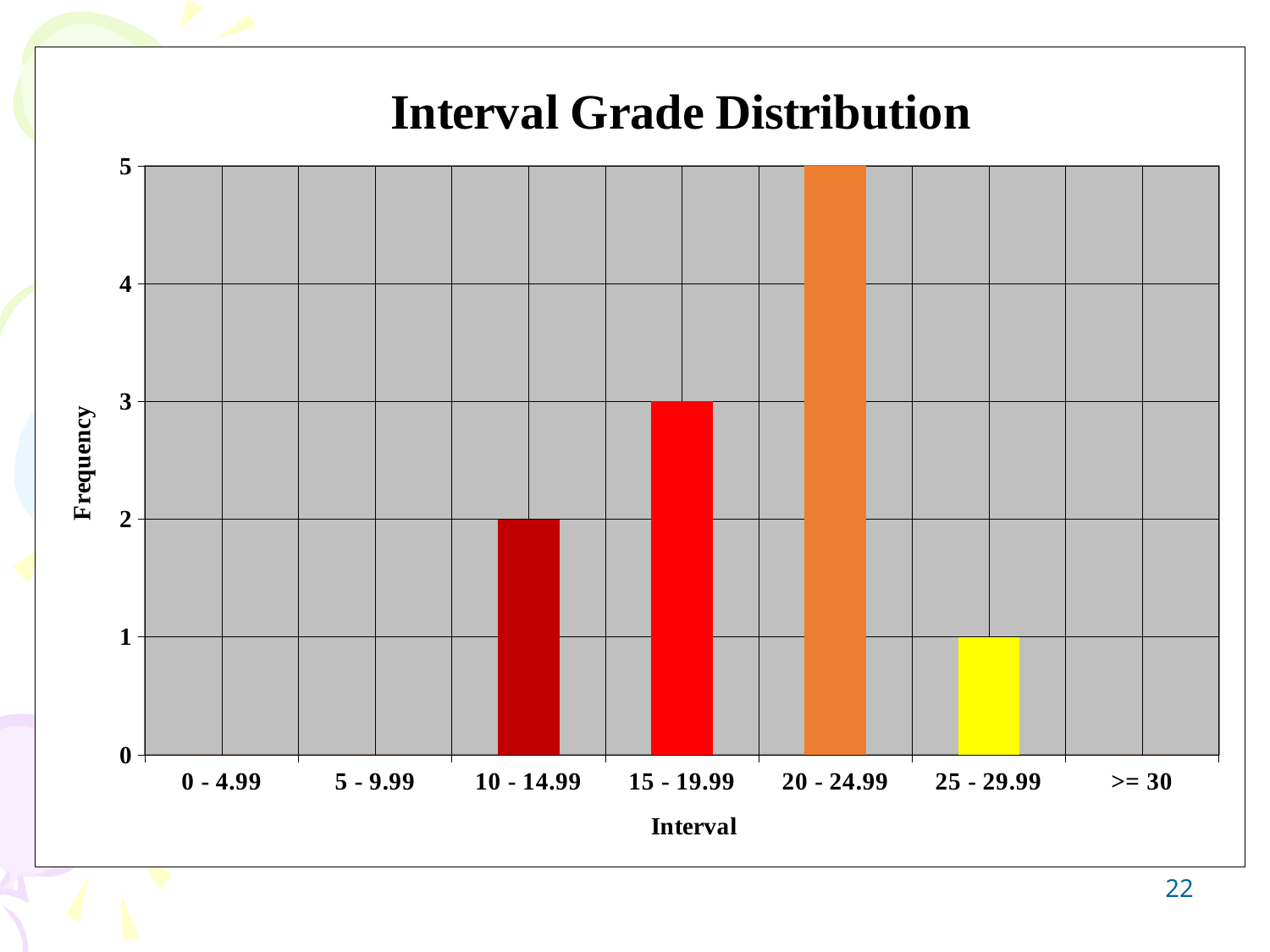
What is the label of the y axis? Frequency What is the frequency for the 10 - 14.99 interval? 2 Which has a higher frequency, the 10 - 14.99 interval or the 25 - 29.99 interval? 10 - 14.99 What is the frequency for the 20 - 24.99 interval? 5 Among the intervals with a visible bar, which has the lowest frequency? 25 - 29.99 Which interval has the highest frequency? 20 - 24.99 What is the difference in frequency between the 20 - 24.99 and 15 - 19.99 intervals? 2 What is the frequency for the 15 - 19.99 interval? 3 What type of chart is shown on the slide? bar chart What is the frequency for the 25 - 29.99 interval? 1 How many interval categories are shown on the x axis? 7 What is the title of the chart? Interval Grade Distribution